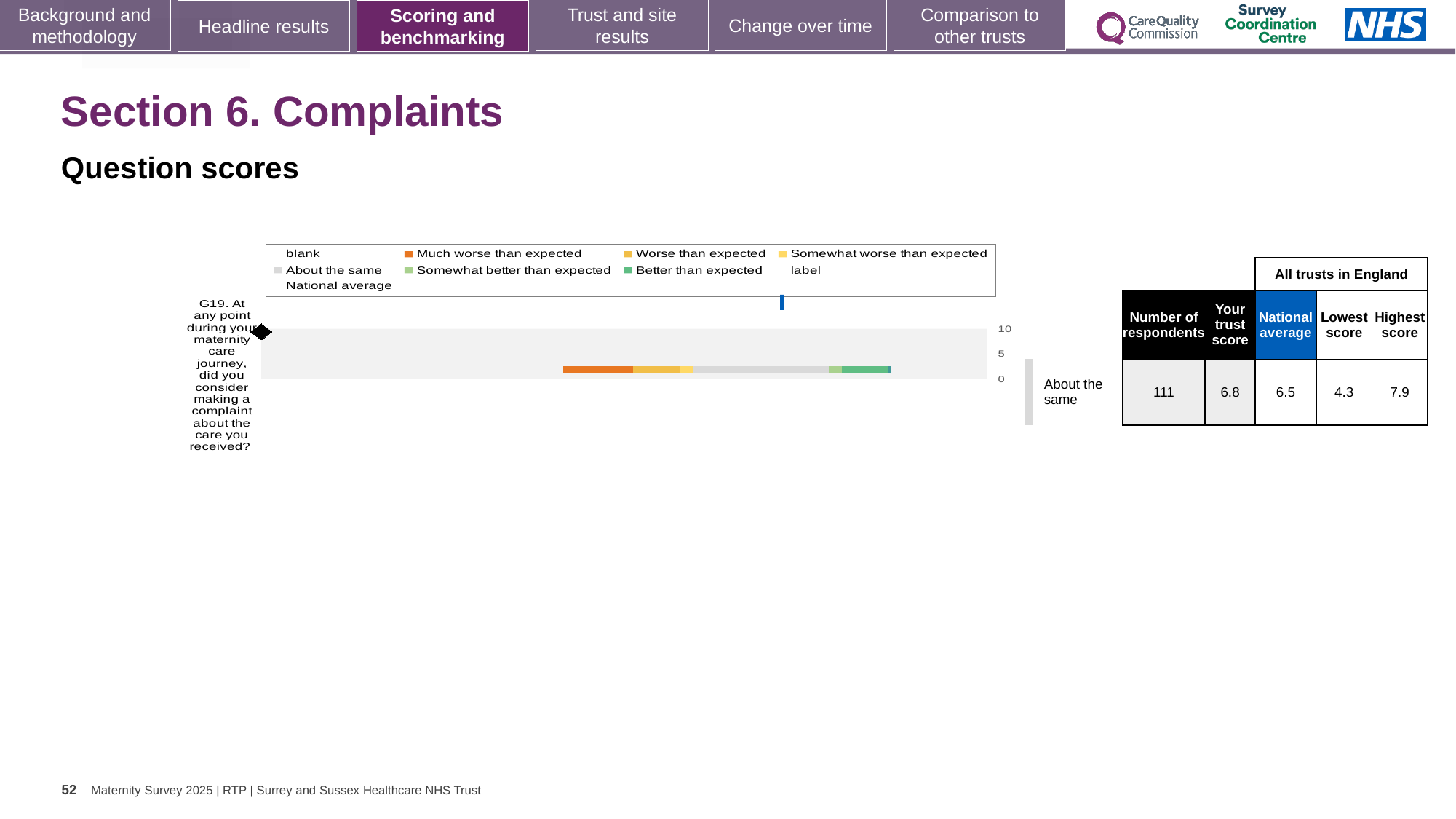
Which is larger for question G19, the trust's score or the national average? the trust's score What is the highest value shown on the chart's score axis? 10 According to the table, what is the national average score for question G19? 6.5 What kind of chart is shown on the slide? bar chart According to the table, what is the trust's score for question G19? 6.8 What is the highest score among all trusts in England for question G19? 7.9 What benchmark category is the trust's score for question G19 placed in? About the same How many survey questions are plotted in the chart? 1 How many respondents answered question G19? 111 Which question number is plotted in the chart? G19 What is the lowest score among all trusts in England for question G19? 4.3 What is the difference between the highest and lowest scores among all trusts in England for question G19? 3.6